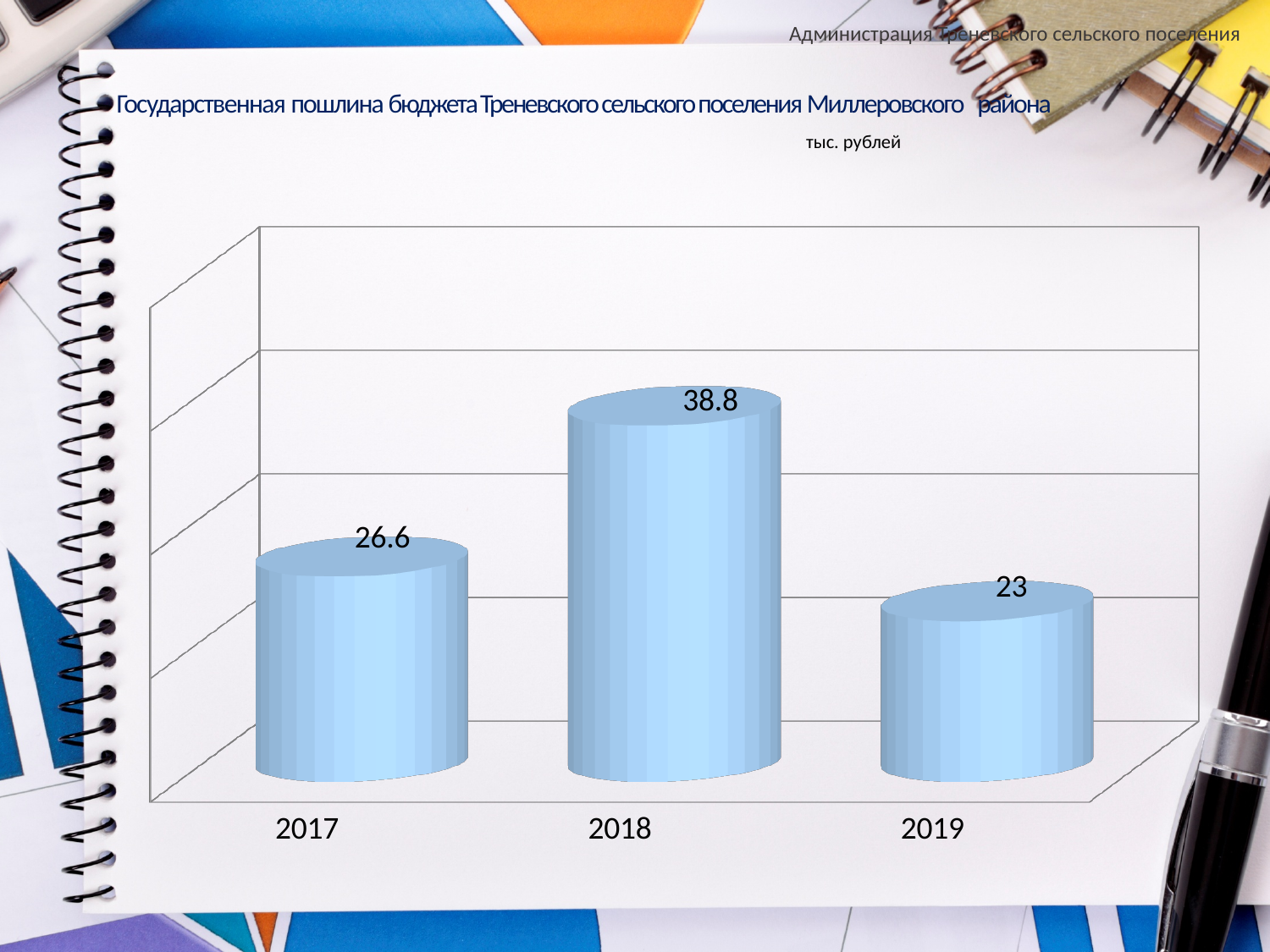
What is the value for 2019? 23 Which is larger, the value for 2017 or the value for 2019? 2017 What is the difference between the values for 2017 and 2019? 3.6 Does the value rise or fall from 2018 to 2019? fall Which year has the lowest value? 2019 Which year has the highest value? 2018 What kind of chart is shown on the slide? bar chart How many years are shown on the chart? 3 What is the difference between the values for 2018 and 2017? 12.2 In what units are the chart values given? тыс. рублей What is the value for 2017? 26.6 What is the value for 2018? 38.8